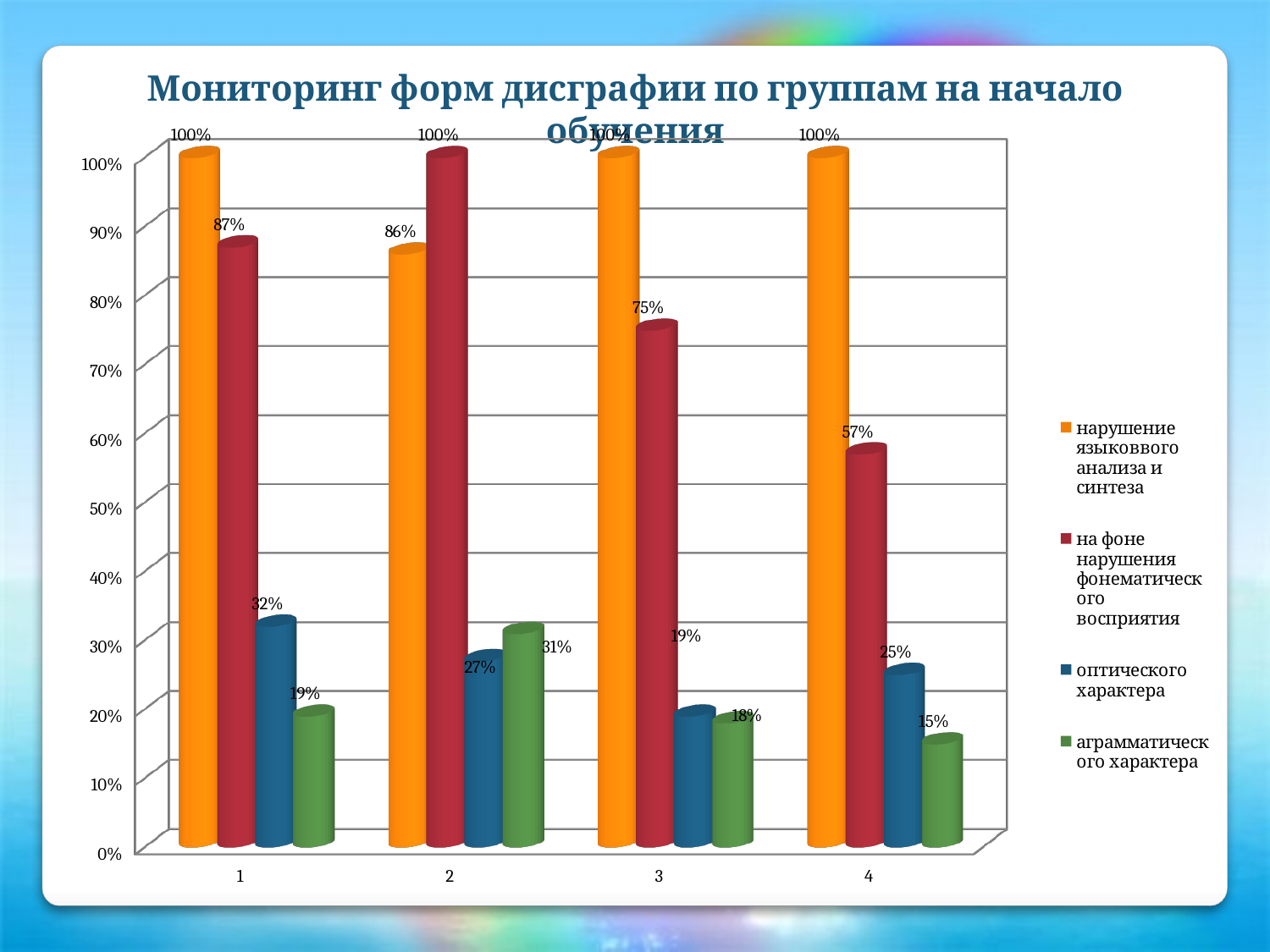
What is the value for group 4 in the series 'оптического характера'? 25% What is the value for group 1 in the series 'на фоне нарушения фонематического восприятия'? 87% Which colour represents the series 'аграмматического характера' in the legend? green What is the value for group 2 in the series 'нарушение языкового анализа и синтеза'? 86% What kind of chart is shown on the slide? bar chart Which group has the highest value in the series 'оптического характера'? 1 Which group has the lowest value in the series 'на фоне нарушения фонематического восприятия'? 4 How many groups are shown on the x axis? 4 What is the value for group 3 in the series 'аграмматического характера'? 18% What is the difference between the 'на фоне нарушения фонематического восприятия' values for group 1 and group 4? 30% How many series does the legend list? 4 For group 2, which is larger: the 'оптического характера' value or the 'аграмматического характера' value? аграмматического характера